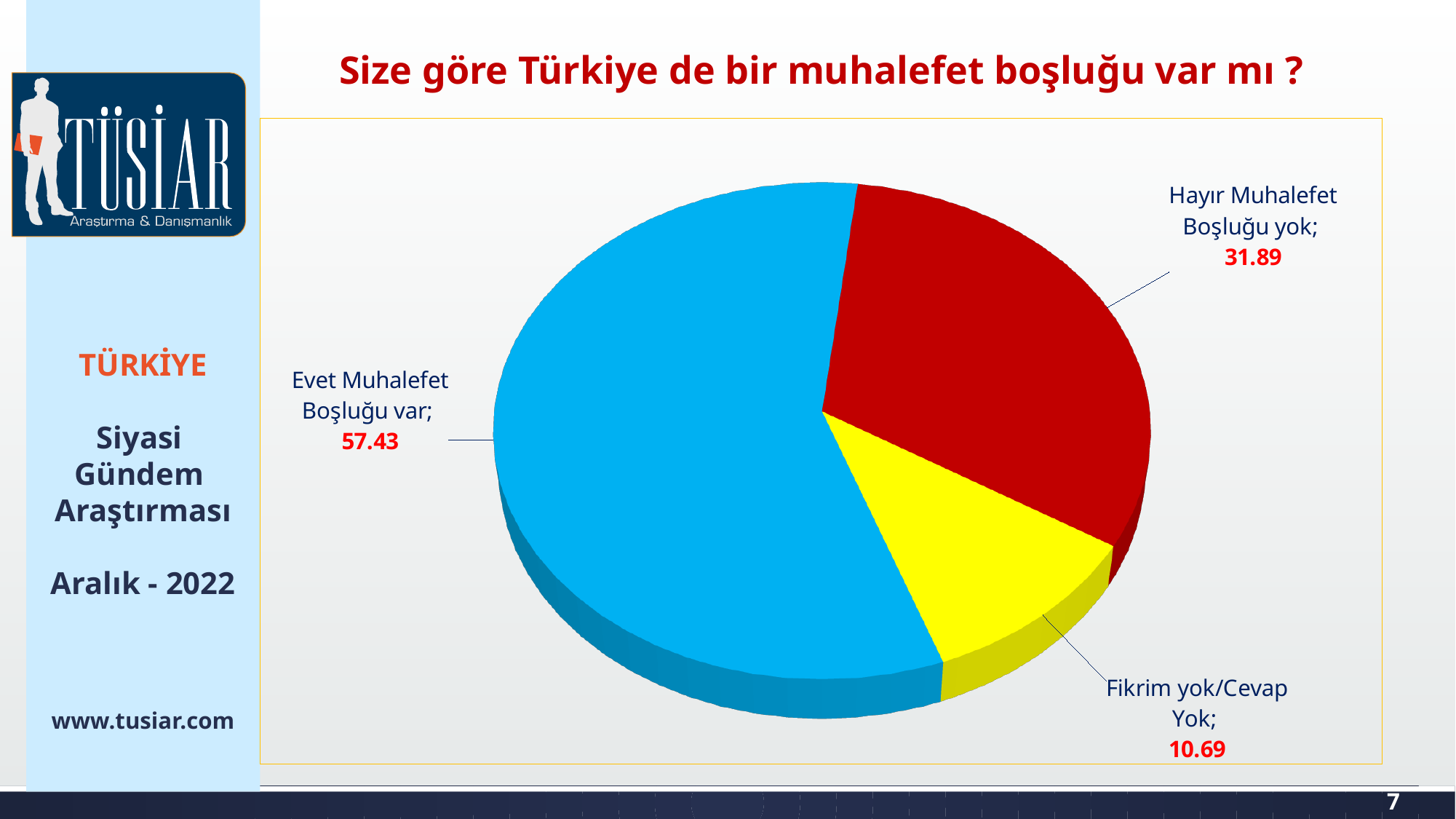
What is the difference between the values for 'Evet Muhalefet Boşluğu var' and 'Hayır Muhalefet Boşluğu yok'? 25.54 What is the title of the chart? Size göre Türkiye de bir muhalefet boşluğu var mı ? Which category has the largest slice? Evet Muhalefet Boşluğu var What is the difference between the values for 'Hayır Muhalefet Boşluğu yok' and 'Fikrim yok/Cevap Yok'? 21.20 Which is larger: 'Hayır Muhalefet Boşluğu yok' or 'Fikrim yok/Cevap Yok'? Hayır Muhalefet Boşluğu yok What is the value for 'Evet Muhalefet Boşluğu var'? 57.43 What type of chart is shown on the slide? pie chart How many slices does the pie chart have? 3 What is the value for 'Hayır Muhalefet Boşluğu yok'? 31.89 Which category has the smallest slice? Fikrim yok/Cevap Yok What is the value for 'Fikrim yok/Cevap Yok'? 10.69 What colour is the slice for 'Fikrim yok/Cevap Yok'? yellow